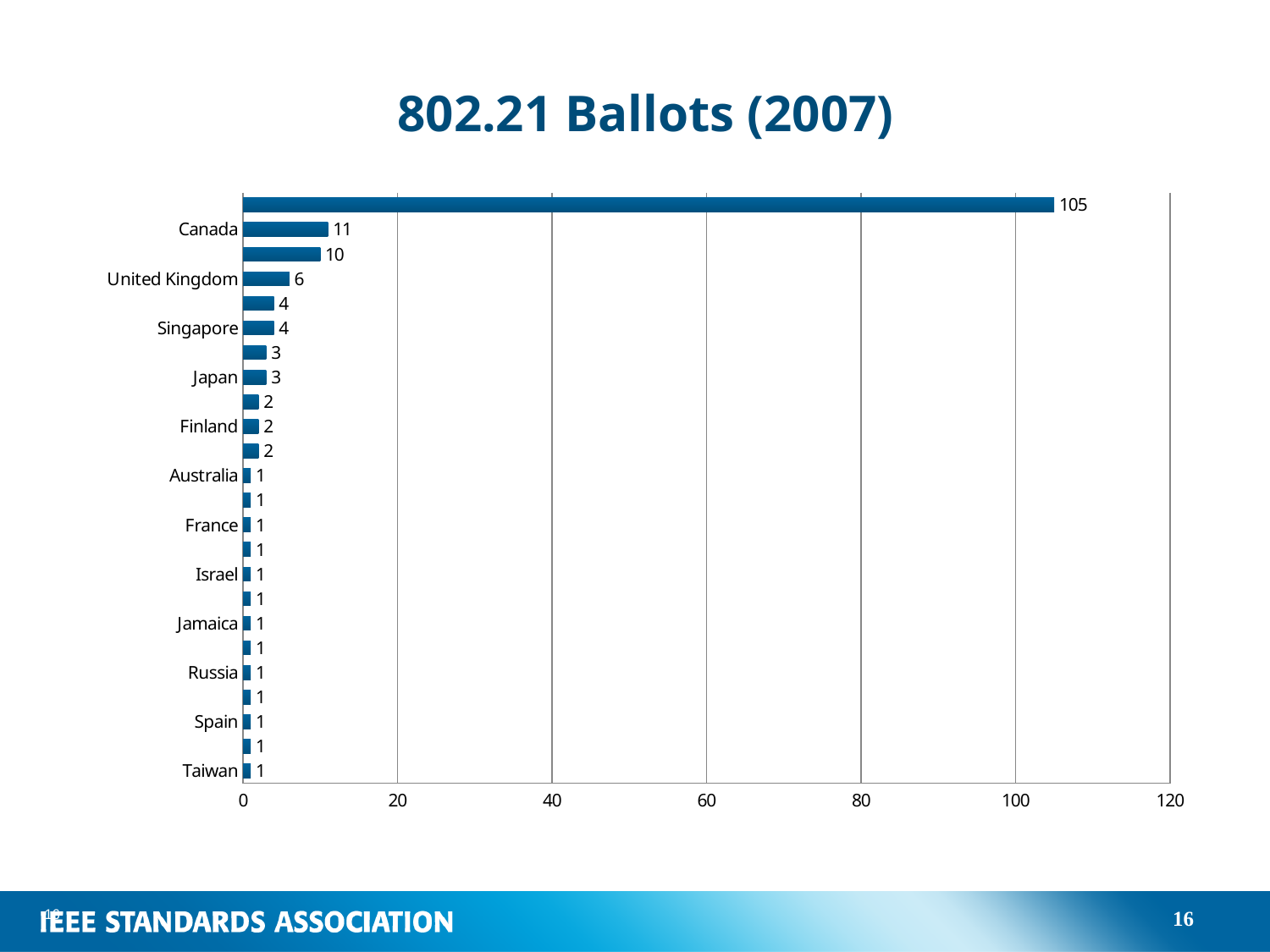
What is the largest value shown on the chart? 105 Is the value of the longest bar greater or less than 100? greater Which has a larger value, Singapore or Japan? Singapore What is the value for Singapore? 4 What kind of chart is shown on the slide? bar chart What is the value for Canada? 11 What is the title of the chart? 802.21 Ballots (2007) What is the value for Taiwan? 1 What is the value for Japan? 3 What is the value for Finland? 2 What is the difference between the values for Canada and United Kingdom? 5 What is the value for United Kingdom? 6